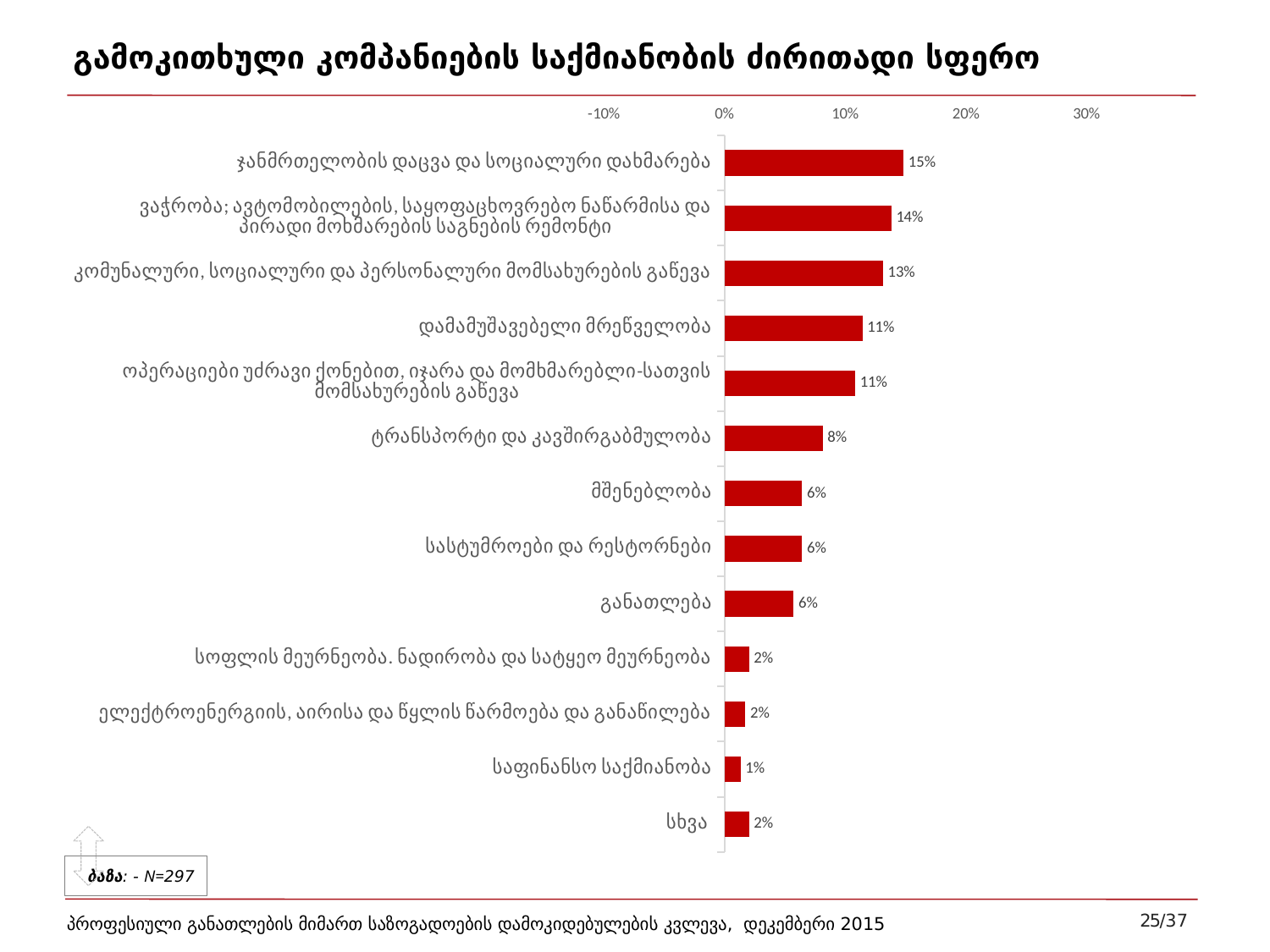
What is the difference between the values for ჯანმრთელობის დაცვა და სოციალური დახმარება and მშენებლობა? 9% Which is larger: the value for კომუნალური, სოციალური და პერსონალური მომსახურების გაწევა or the value for განათლება? კომუნალური, სოციალური და პერსონალური მომსახურების გაწევა What kind of chart is shown on the slide? bar chart What is the value for დამამუშავებელი მრეწველობა? 11% Is the value for ვაჭრობა; ავტომობილების, საყოფაცხოვრებო ნაწარმისა და პირადი მოხმარების საგნების რემონტი greater or less than 10%? greater What is the value for ტრანსპორტი და კავშირგაბმულობა? 8% Which category has the lowest value? საფინანსო საქმიანობა Which category has the highest value? ჯანმრთელობის დაცვა და სოციალური დახმარება What is the value for ჯანმრთელობის დაცვა და სოციალური დახმარება? 15% How many categories are shown in the chart? 13 What is the title of the chart? გამოკითხული კომპანიების საქმიანობის ძირითადი სფერო What is the value for საფინანსო საქმიანობა? 1%